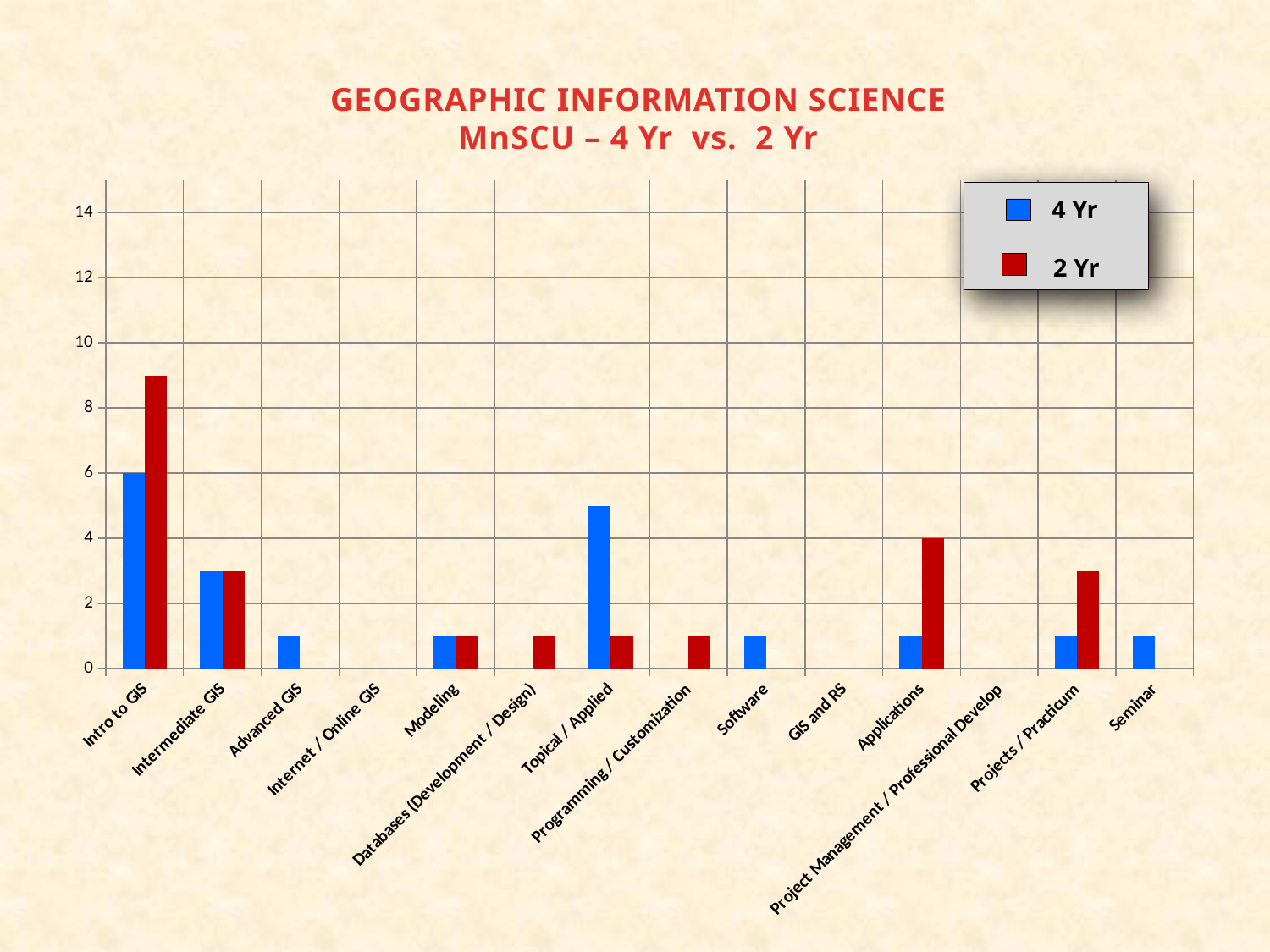
Which category has the highest 4 Yr value? Intro to GIS How many categories are shown on the x axis? 14 Is the 2 Yr value for Projects / Practicum greater or less than 4? less Which category has the highest 2 Yr value? Intro to GIS What is the 4 Yr value for Intro to GIS? 6 For Topical / Applied, which is larger, the 4 Yr value or the 2 Yr value? 4 Yr For Intro to GIS, which is larger, the 4 Yr value or the 2 Yr value? 2 Yr How many series does the legend list? 2 What is the 2 Yr value for Applications? 4 What type of chart is shown on the slide? bar chart Is the 2 Yr value for Intro to GIS greater or less than 8? greater What are the two series names shown in the legend? 4 Yr and 2 Yr